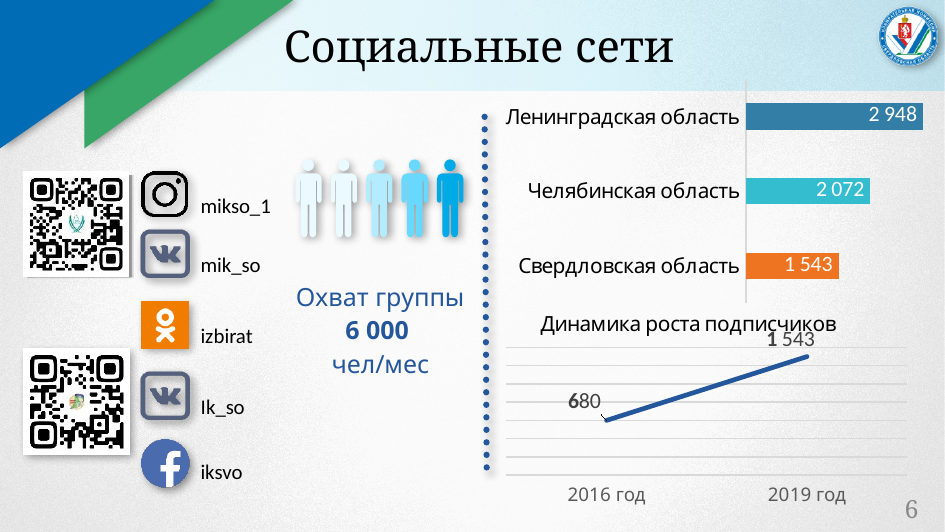
In the chart titled 'Динамика роста подписчиков', what is the value for 2016 год? 680 In the bar chart at the top right, which is larger: the value for Челябинская область or Свердловская область? Челябинская область How many regions are shown in the bar chart at the top right? 3 In the bar chart at the top right, what is the difference between the values for Ленинградская область and Свердловская область? 1 405 In the bar chart at the top right, what is the value for Свердловская область? 1 543 In the bar chart at the top right, which region has the highest value? Ленинградская область What kind of chart is the chart at the top right of the slide? bar chart In the bar chart at the top right, which region has the lowest value? Свердловская область In the chart titled 'Динамика роста подписчиков', what is the value for 2019 год? 1 543 In the bar chart at the top right, what is the value for Ленинградская область? 2 948 In the chart titled 'Динамика роста подписчиков', do the values rise or fall from 2016 год to 2019 год? rise In the bar chart at the top right, what is the value for Челябинская область? 2 072